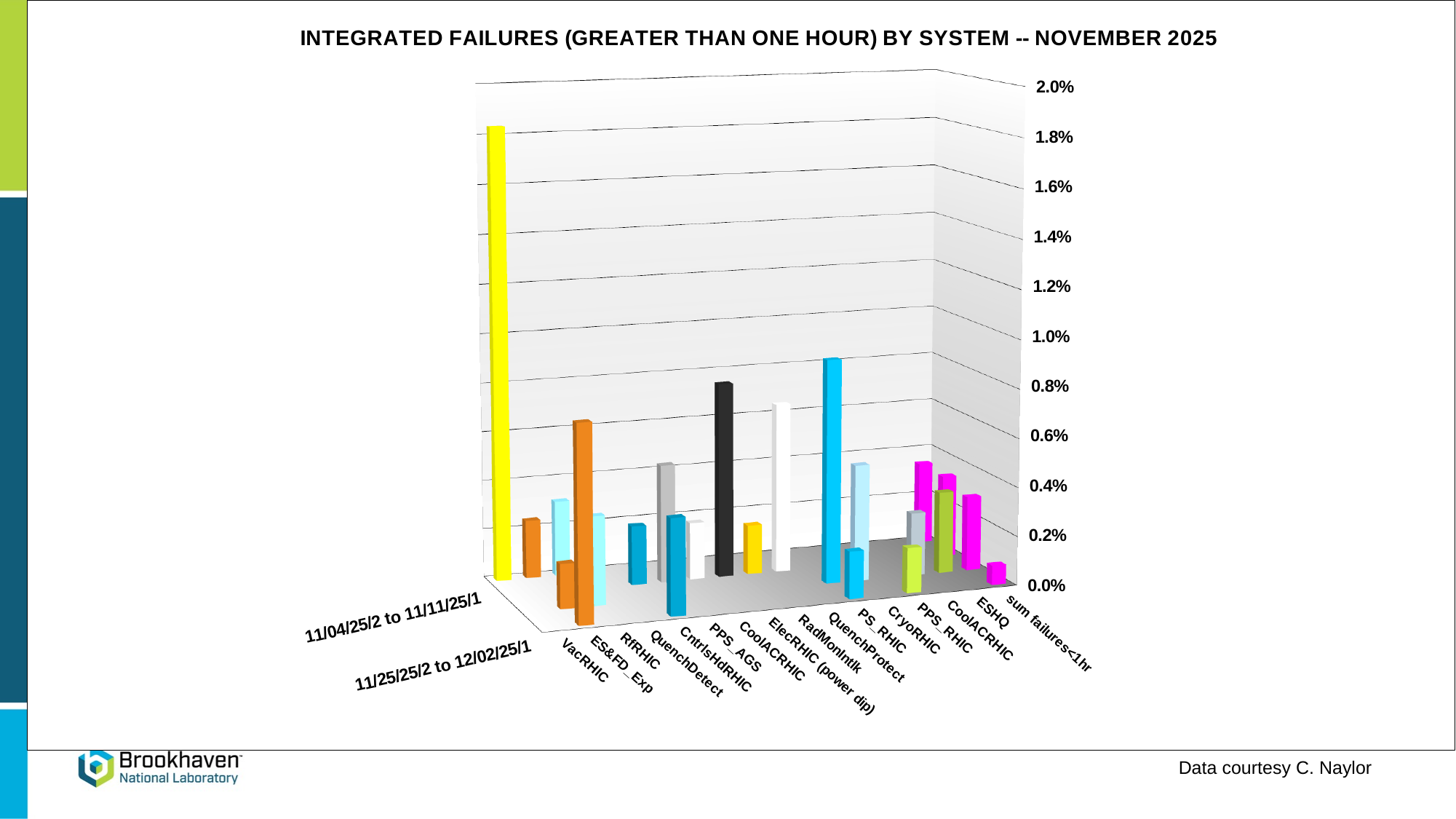
How many system categories are shown along the x axis of the chart? 16 Which system has the tallest bar in the chart? VacRHIC What kind of chart is shown on the slide? bar chart Is the tallest bar (VacRHIC) greater or less than 1.4%? greater What is the maximum value shown on the vertical axis? 2.0% Which is larger, the tallest bar for VacRHIC or the tallest bar for PPS_AGS? VacRHIC Is the value for ESHQ greater or less than 0.6%? less What is the title of the chart? INTEGRATED FAILURES (GREATER THAN ONE HOUR) BY SYSTEM -- NOVEMBER 2025